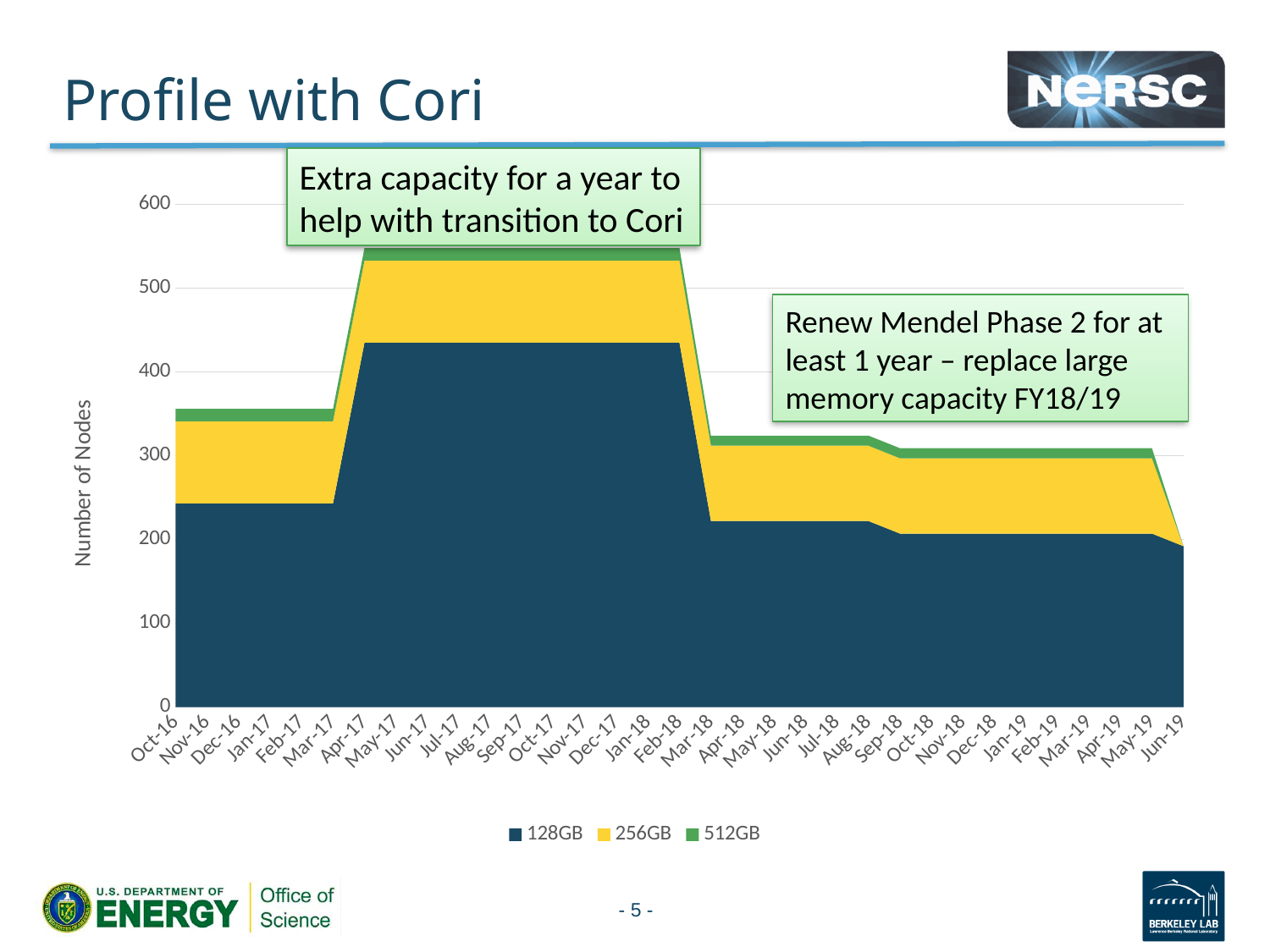
What kind of chart is shown on the slide? Stacked area chart What is the label on the vertical axis of the chart? Number of Nodes How many series does the chart legend list? 3 Which series contributes the most nodes in Oct-16, 128GB or 512GB? 128GB Is the total number of nodes in Jun-17 greater or less than 500? greater Does the total number of nodes rise or fall from Mar-17 to Apr-17? Rise Is the value for the 128GB series in May-17 greater or less than 400? greater How many months are shown along the x axis, from Oct-16 to Jun-19? 33 Does the total number of nodes rise or fall from Feb-18 to Mar-18? Fall Is the value for the 128GB series in Oct-16 greater or less than 300? less What are the three series named in the chart legend? 128GB, 256GB, 512GB